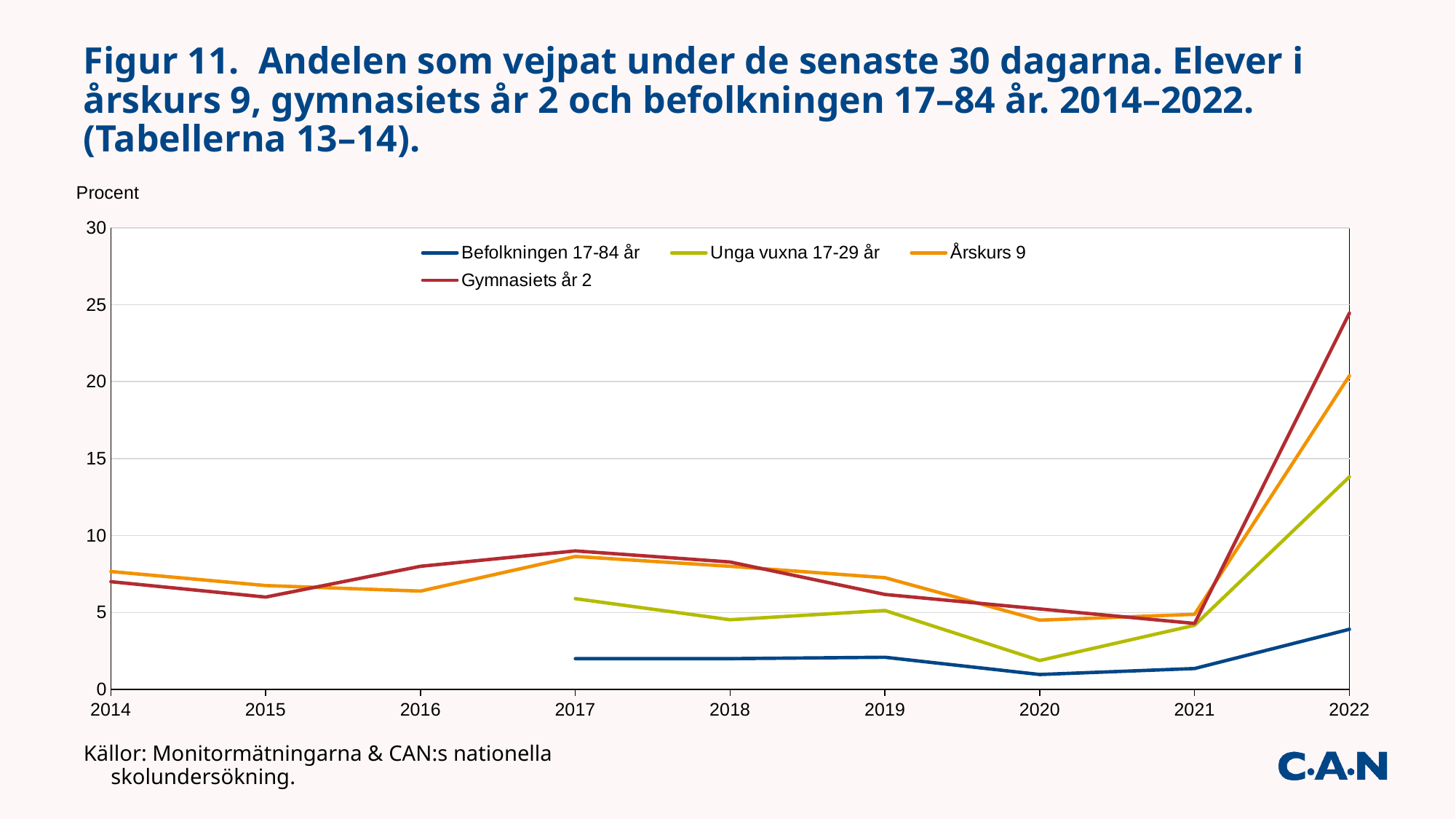
In which year is the value for Unga vuxna 17-29 år lowest? 2020 Does the value for Gymnasiets år 2 rise or fall from 2017 to 2021? fall Which is larger in 2019, the value for Årskurs 9 or the value for Gymnasiets år 2? Årskurs 9 Which series has the highest value in 2022? Gymnasiets år 2 Is the value for Gymnasiets år 2 in 2022 greater or less than 20? greater Which series has the lowest value in 2022? Befolkningen 17-84 år Is the value for Befolkningen 17-84 år in 2022 greater or less than 5? less What kind of chart is shown on the slide? line chart How many years are shown along the x axis? 9 Is the value for Unga vuxna 17-29 år in 2022 greater or less than 15? less How many series does the legend list? 4 What is the label on the y axis? Procent